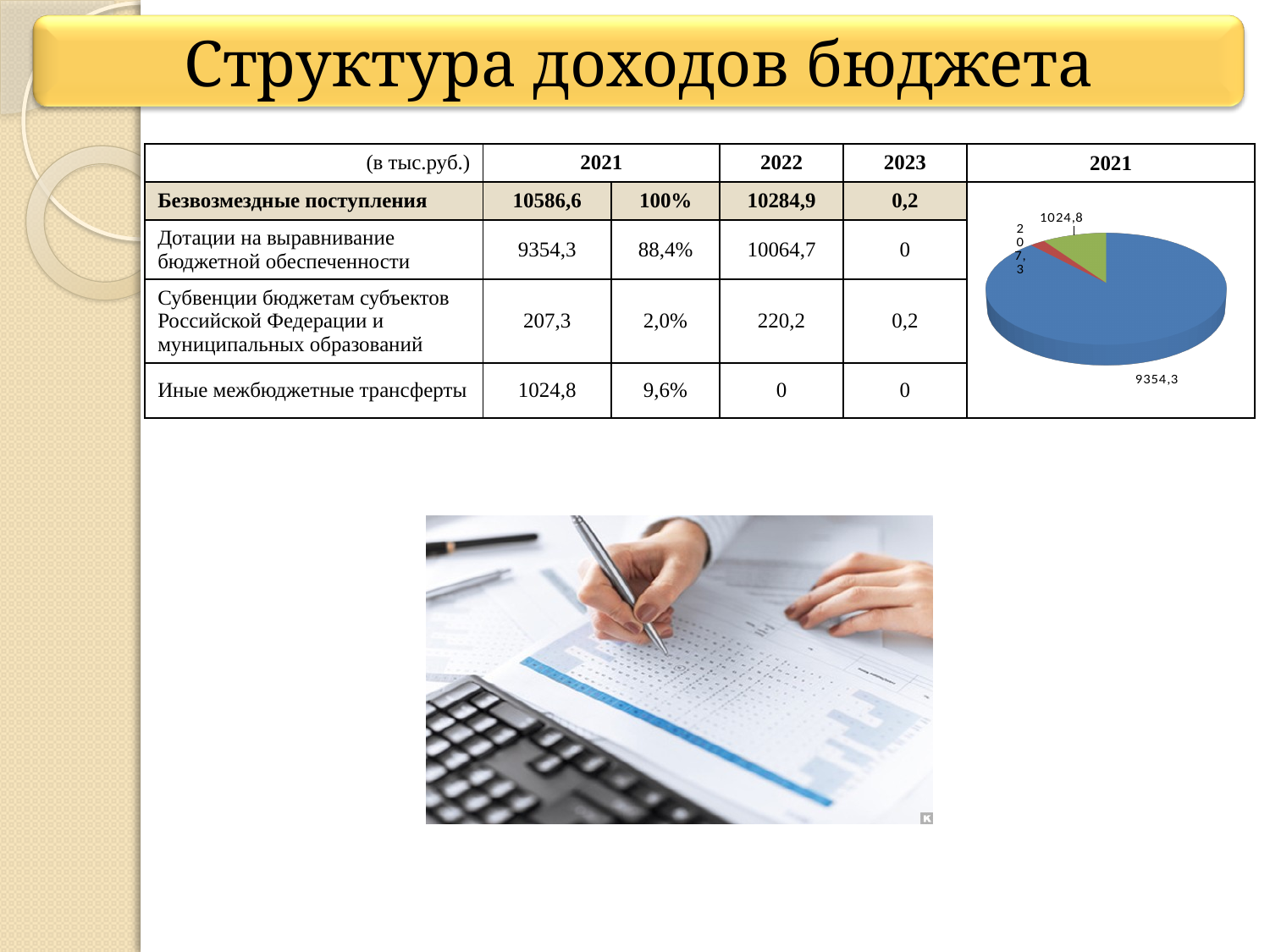
Which slice is larger in the pie chart, the one labelled 1024,8 or the one labelled 207,3? 1024,8 What value is labelled on the red slice of the pie chart? 207,3 What is the title of the pie chart? 2021 What value is labelled on the blue slice of the pie chart? 9354,3 What kind of chart is shown on the slide? pie chart What colour is the largest slice of the pie chart? blue How many slices does the pie chart have? 3 What is the value of the smallest slice in the pie chart? 207,3 What is the value of the largest slice in the pie chart? 9354,3 What value is labelled on the green slice of the pie chart? 1024,8 What is the difference between the slice labelled 1024,8 and the slice labelled 207,3 in the pie chart? 817,5 What is the difference between the slice labelled 9354,3 and the slice labelled 1024,8 in the pie chart? 8329,5